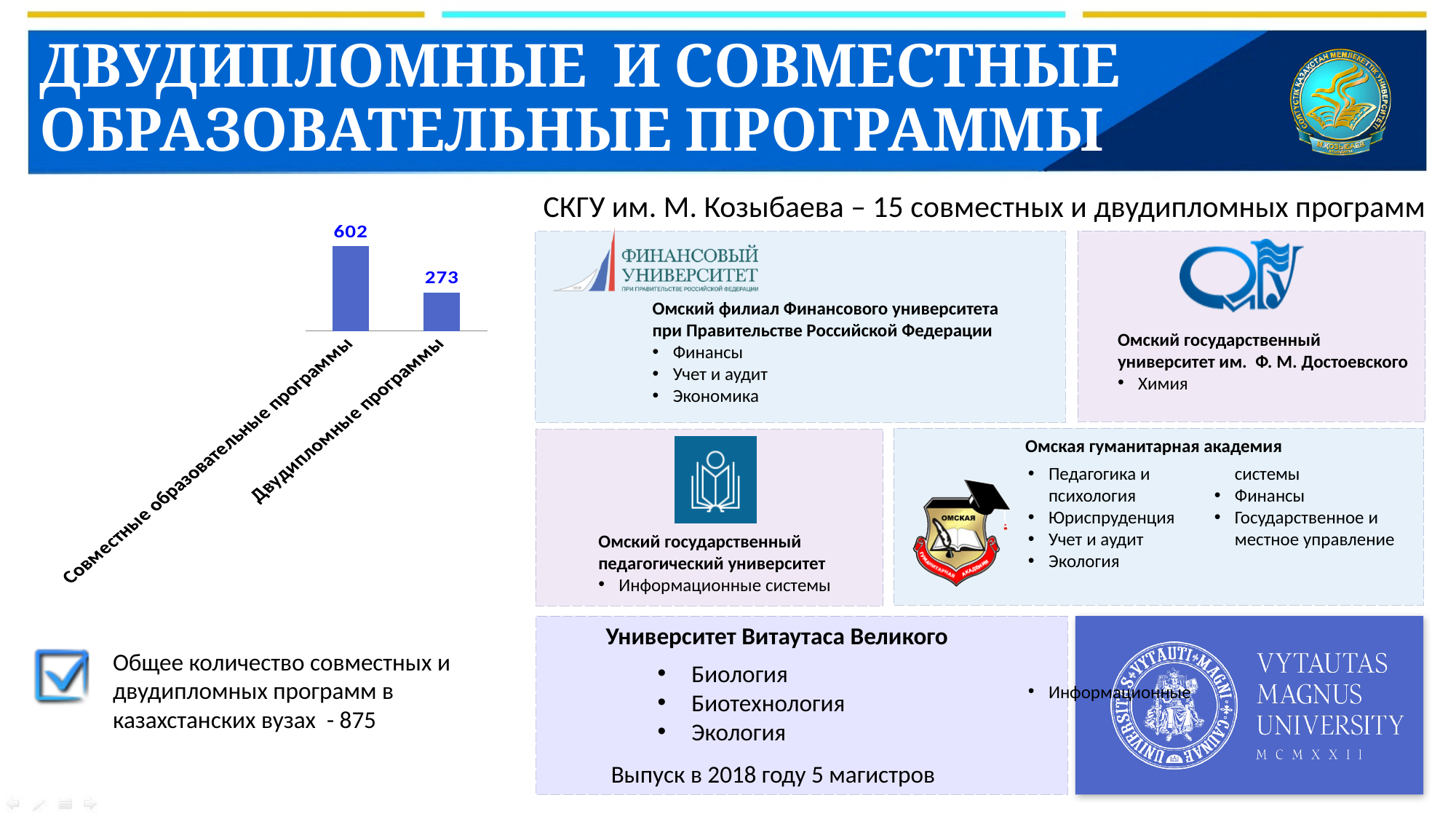
What colour are the bars in the chart? Blue How many categories are shown in the bar chart? 2 Which is larger: the value for Совместные образовательные программы or the value for Двудипломные программы? Совместные образовательные программы Which category has the lowest value? Двудипломные программы What is the difference between the values for Совместные образовательные программы and Двудипломные программы? 329 Do the values rise or fall from left to right along the x axis? Fall Which category has the highest value? Совместные образовательные программы What is the value for Двудипломные программы? 273 What is the value for Совместные образовательные программы? 602 What kind of chart is shown on the slide? Bar chart What is the combined total of the two bars in the chart? 875